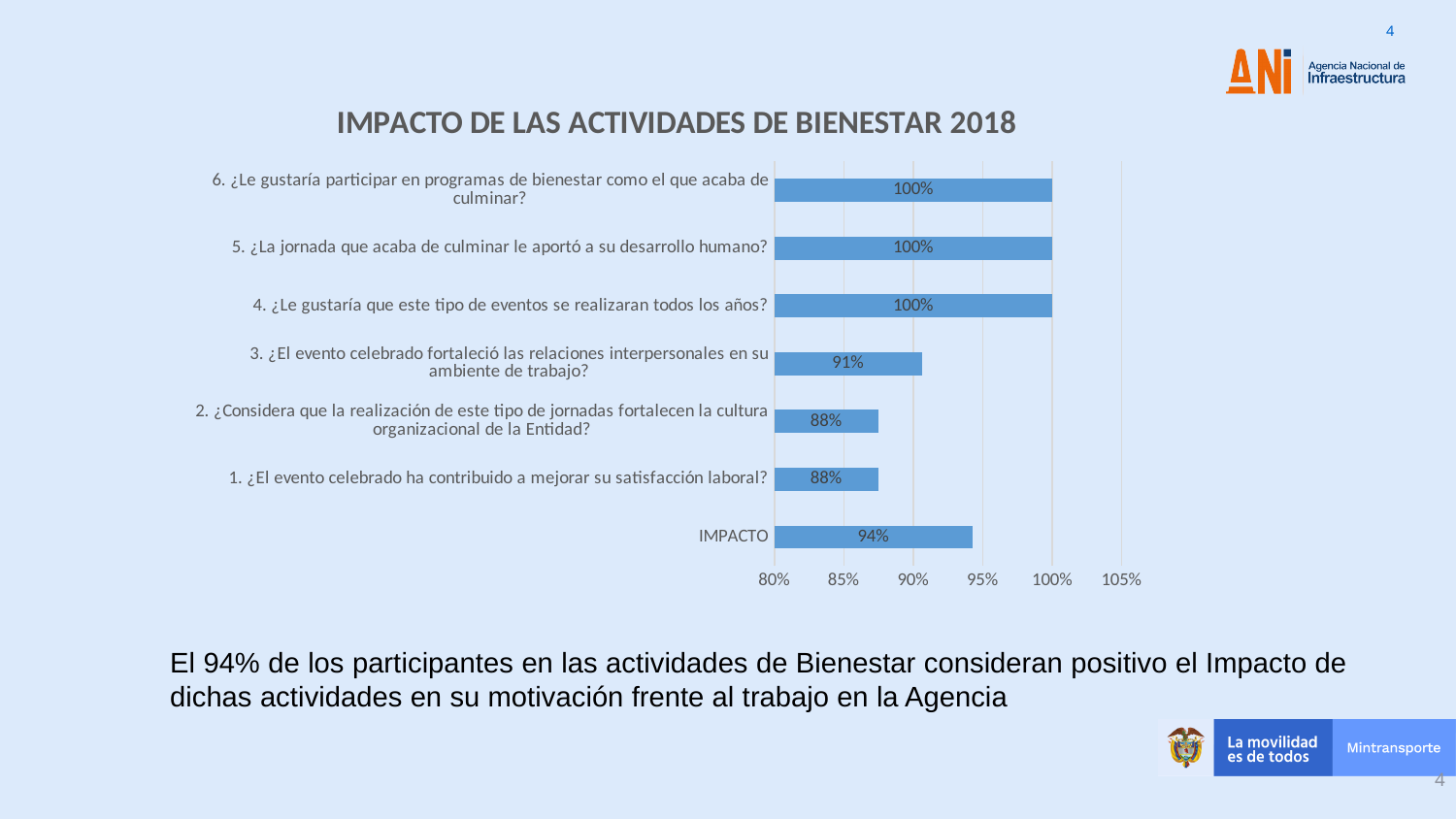
What is the difference between the value for question 3 and the value for question 2? 3% Which is larger, the value for IMPACTO or the value for question 3? IMPACTO Which category has the lowest value? Questions 1 and 2 (88%) What is the value for question 3, '¿El evento celebrado fortaleció las relaciones interpersonales en su ambiente de trabajo?'? 91% What is the value for question 5, '¿La jornada que acaba de culminar le aportó a su desarrollo humano?'? 100% What is the value for question 1, '¿El evento celebrado ha contribuido a mejorar su satisfacción laboral?'? 88% What type of chart is shown on the slide? Bar chart How many categories have a value of 100%? 3 What is the title of the chart? IMPACTO DE LAS ACTIVIDADES DE BIENESTAR 2018 How many bars are shown in the chart? 7 What is the value for IMPACTO? 94% What is the difference between the value for question 4 and the IMPACTO value? 6%